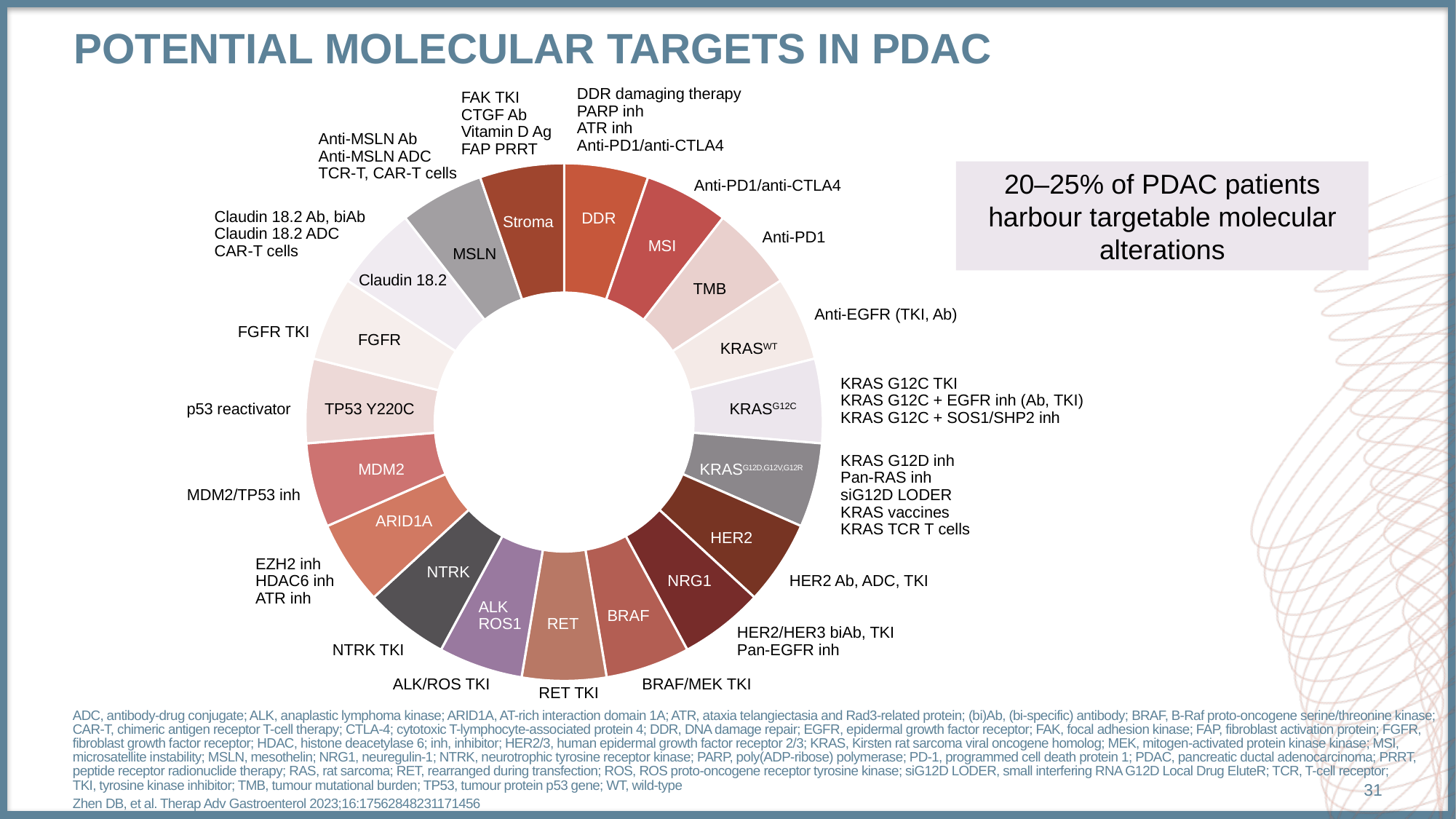
What kind of chart is shown on the slide? Doughnut chart Which therapy is listed next to the BRAF segment? BRAF/MEK TKI According to the text box on the slide, what percentage of PDAC patients harbour targetable molecular alterations? 20–25% Which therapy is listed next to the RET segment? RET TKI Which therapy is listed next to the NTRK segment? NTRK TKI Which therapies are listed next to the HER2 segment? HER2 Ab, ADC, TKI Which segment sits between the DDR and TMB segments in the doughnut chart? MSI Which therapy is listed next to the MDM2 segment? MDM2/TP53 inh How many segments does the doughnut chart have? 19 Which therapy is listed next to the FGFR segment? FGFR TKI Which therapy is listed next to the TP53 Y220C segment? p53 reactivator